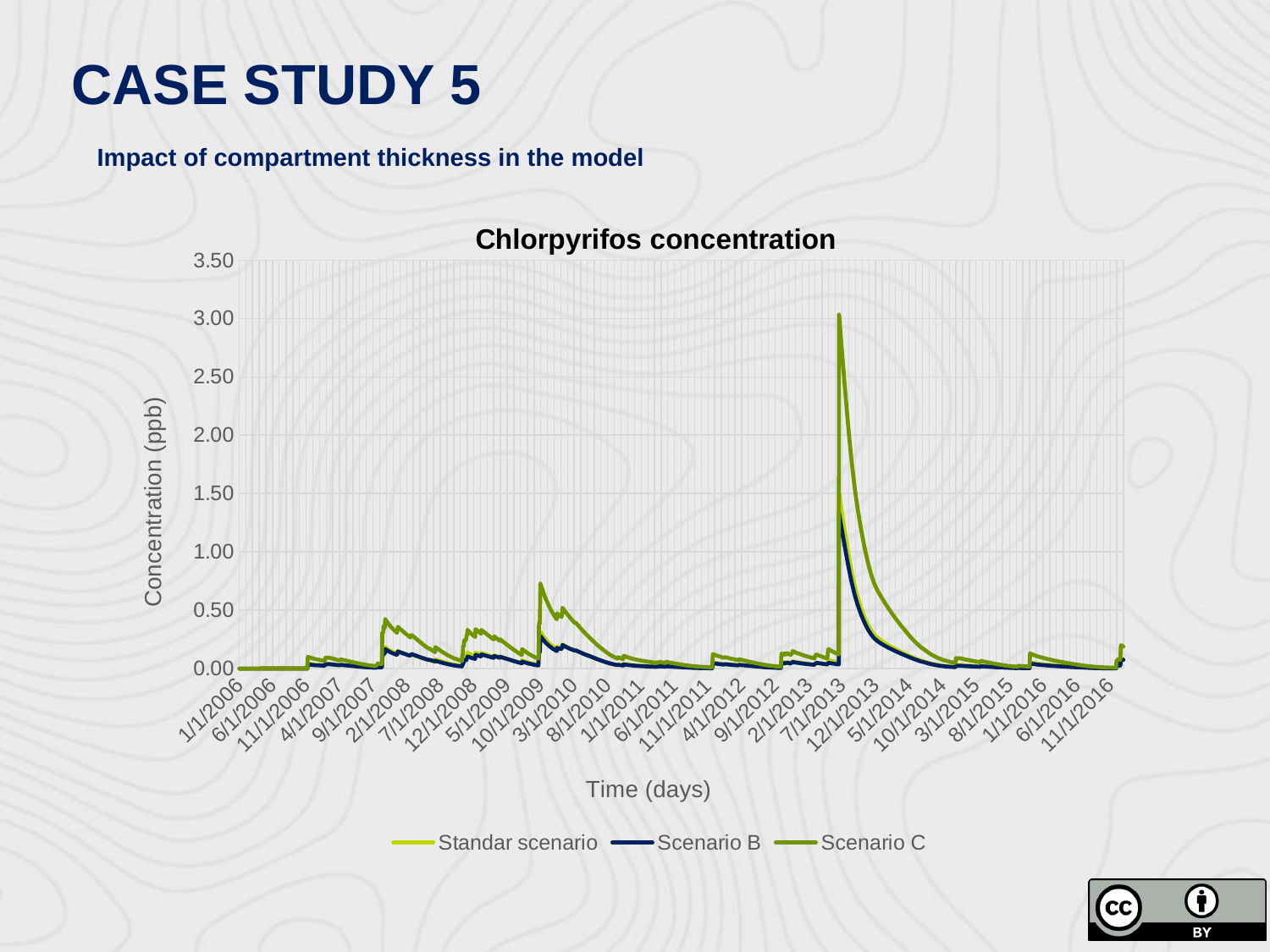
Which series reaches the highest peak in the Chlorpyrifos concentration chart? Scenario C What type of chart is shown on the slide? line chart Around 3/1/2010, which series has the larger peak: Scenario C or Scenario B? Scenario C Is the peak of Scenario C around 3/1/2010 greater or less than 1.00? less How many series does the legend of the Chlorpyrifos concentration chart list? 3 What is the title of the chart on the slide? Chlorpyrifos concentration Is the highest peak of Scenario C (around 7/1/2013) greater or less than 2.50? greater What is the label of the vertical axis of the chart? Concentration (ppb) Is the highest peak of Scenario B (around 7/1/2013) greater or less than 1.50? less At the large peak around 7/1/2013, which series has the larger value: Scenario C or Scenario B? Scenario C